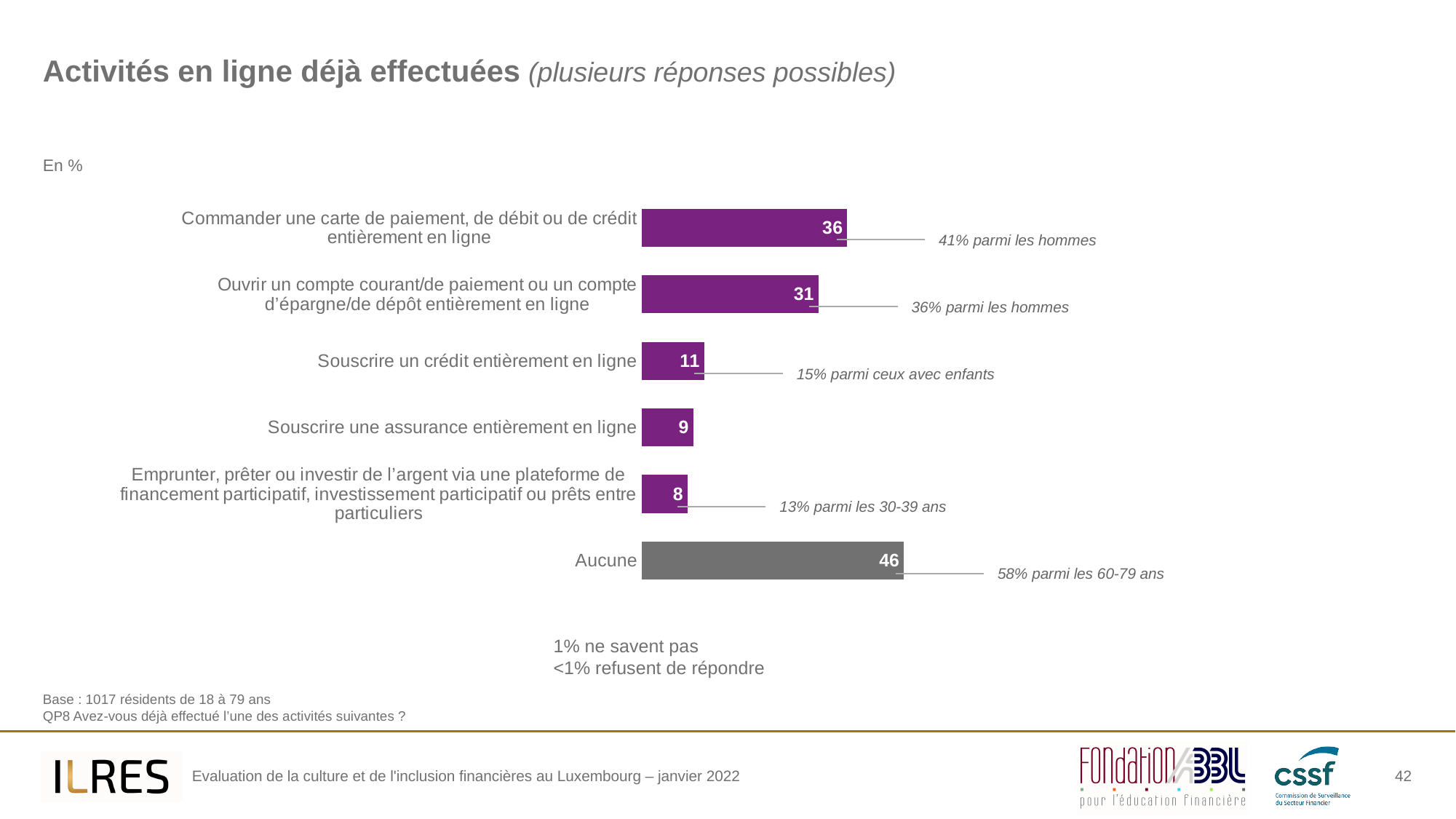
How many categories are shown in the bar chart? 6 Which is larger: the value for "Souscrire un crédit entièrement en ligne" or for "Souscrire une assurance entièrement en ligne"? Souscrire un crédit entièrement en ligne What is the value for "Commander une carte de paiement, de débit ou de crédit entièrement en ligne"? 36 What is the value for "Aucune"? 46 What is the title of the chart? Activités en ligne déjà effectuées (plusieurs réponses possibles) According to the annotation, what is the share of "Aucune" among 60-79 year olds? 58% What is the difference between the value for "Aucune" and the value for "Commander une carte de paiement, de débit ou de crédit entièrement en ligne"? 10 What is the value for "Souscrire une assurance entièrement en ligne"? 9 What kind of chart is shown on the slide? Bar chart Which category has the highest value? Aucune Which category has the lowest value? Emprunter, prêter ou investir de l'argent via une plateforme de financement participatif, investissement participatif ou prêts entre particuliers What is the difference between the values for "Commander une carte de paiement, de débit ou de crédit entièrement en ligne" and "Ouvrir un compte courant/de paiement ou un compte d'épargne/de dépôt entièrement en ligne"? 5